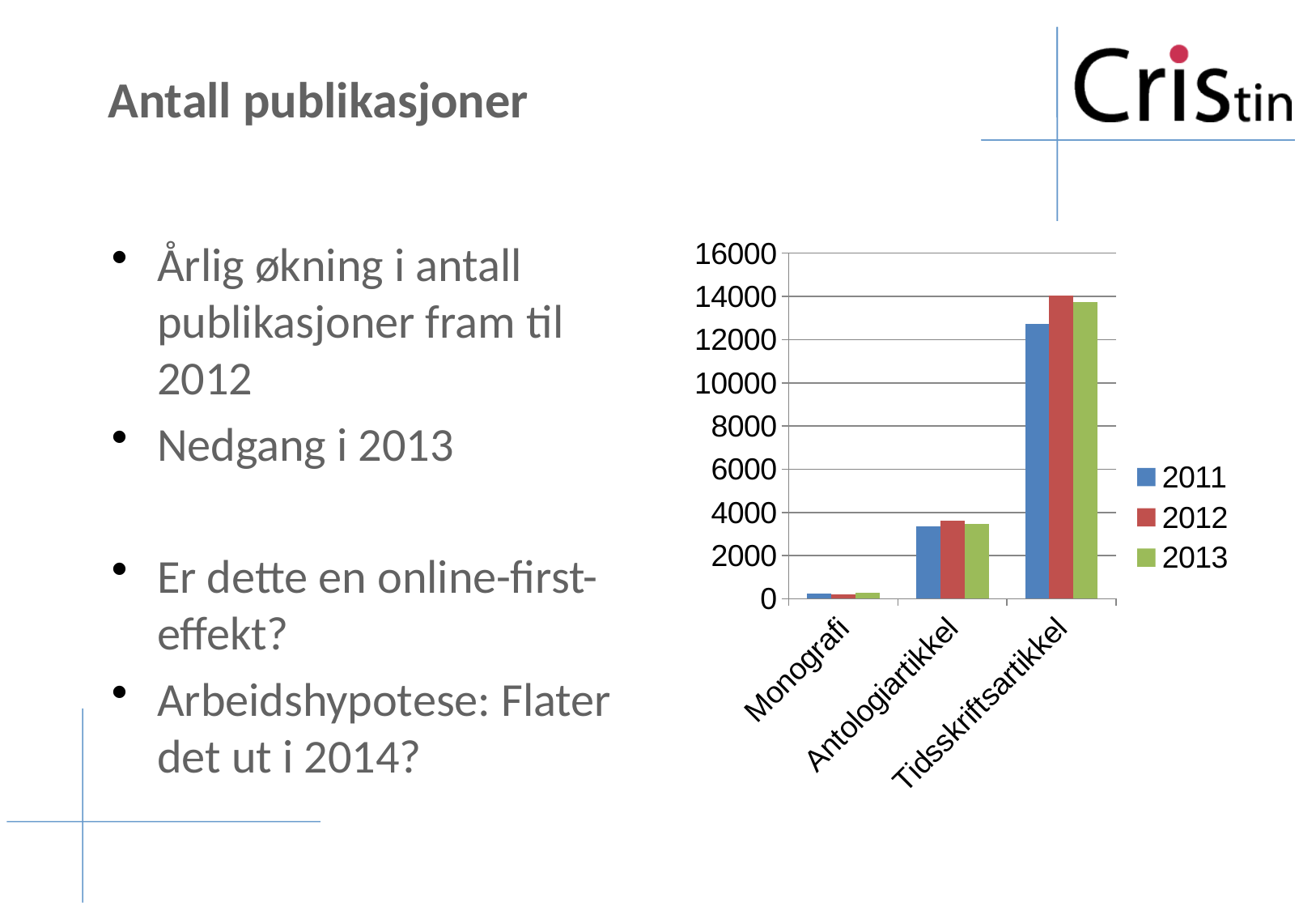
Is the 2012 value for Antologiartikkel greater or less than 4000? less How many series does the chart's legend list? 3 Is the 2011 value for Tidsskriftsartikkel greater or less than 14000? less How many categories are shown on the x axis of the chart? 3 Which category has the highest values in the chart? Tidsskriftsartikkel Is the 2013 value for Antologiartikkel greater or less than 2000? greater Which years are listed in the chart's legend? 2011, 2012, 2013 For Tidsskriftsartikkel, which is larger: the 2011 value or the 2012 value? 2012 What kind of chart is shown on the slide? bar chart Which category has the lowest values in the chart? Monografi What colour represents the 2013 series in the chart? green